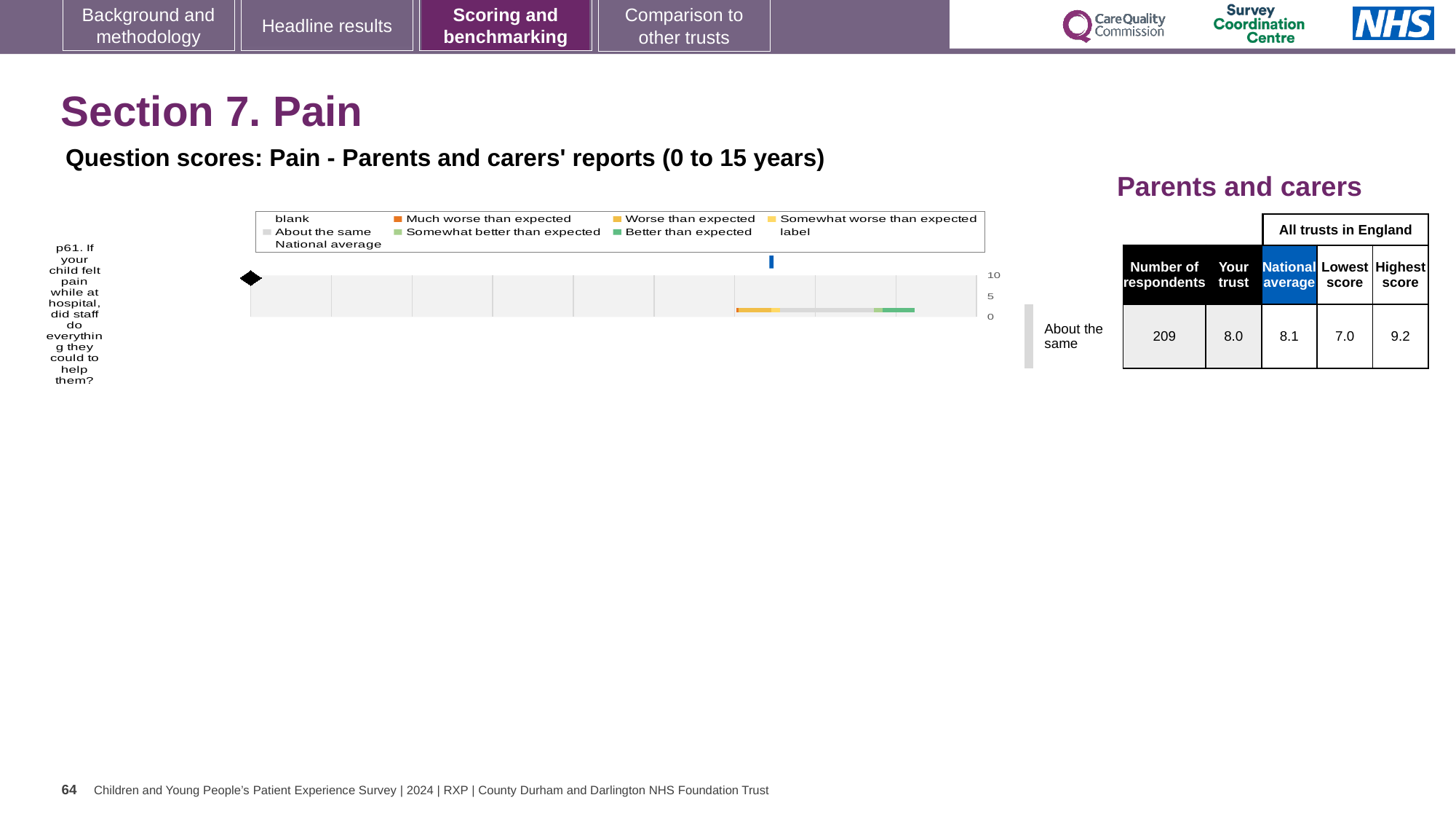
What kind of chart is shown on the slide? Bar chart In the table, what is the Lowest score among all trusts in England? 7.0 In the table, what is the difference between the Highest score and the Lowest score? 2.2 In the table, what is the 'Your trust' score for the question 'About the same'? 8.0 In the table, how many respondents are listed? 209 In the table, which is larger: the Your trust score or the National average score? National average Which question number is plotted in the chart? p61 In the table, what is the National average score? 8.1 What colour in the chart legend represents 'Better than expected'? Green In the table, what is the Highest score among all trusts in England? 9.2 How many questions (categories) are plotted in the chart? 1 In the table, what is the difference between the National average and the Your trust score? 0.1